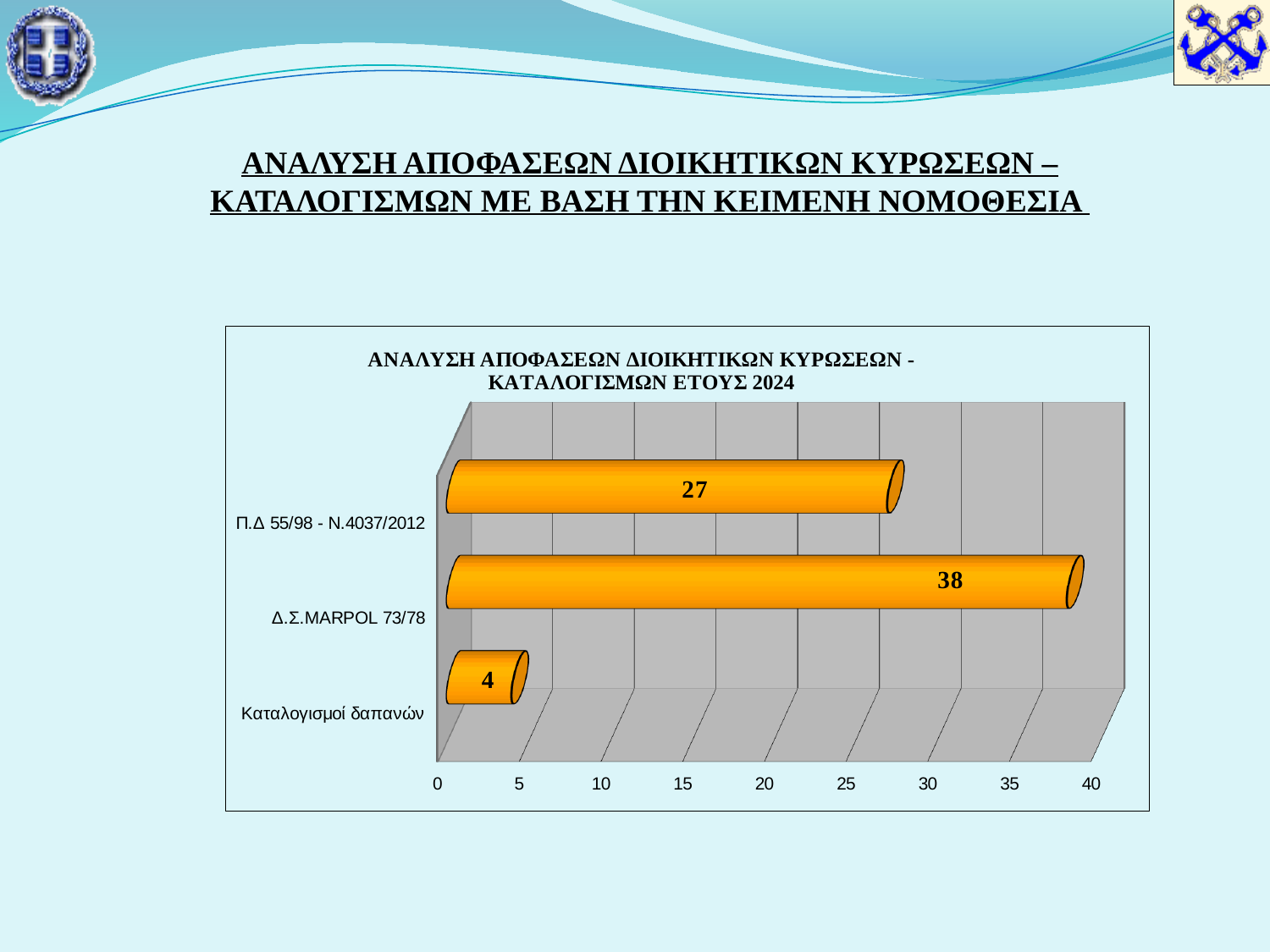
What is the difference between the values for Δ.Σ.MARPOL 73/78 and Π.Δ 55/98 - Ν.4037/2012? 11 Which is larger, the value for Π.Δ 55/98 - Ν.4037/2012 or the value for Δ.Σ.MARPOL 73/78? Δ.Σ.MARPOL 73/78 Is the value for Π.Δ 55/98 - Ν.4037/2012 greater or less than 25? greater What is the value for Δ.Σ.MARPOL 73/78? 38 What is the title of the chart? ΑΝΑΛΥΣΗ ΑΠΟΦΑΣΕΩΝ ΔΙΟΙΚΗΤΙΚΩΝ ΚΥΡΩΣΕΩΝ - ΚΑΤΑΛΟΓΙΣΜΩΝ ΕΤΟΥΣ 2024 Which category has the highest value? Δ.Σ.MARPOL 73/78 What is the difference between the values for Π.Δ 55/98 - Ν.4037/2012 and Καταλογισμοί δαπανών? 23 What is the value for Π.Δ 55/98 - Ν.4037/2012? 27 Which category has the lowest value? Καταλογισμοί δαπανών What kind of chart is shown on the slide? bar chart What is the value for Καταλογισμοί δαπανών? 4 How many categories are shown in the chart? 3